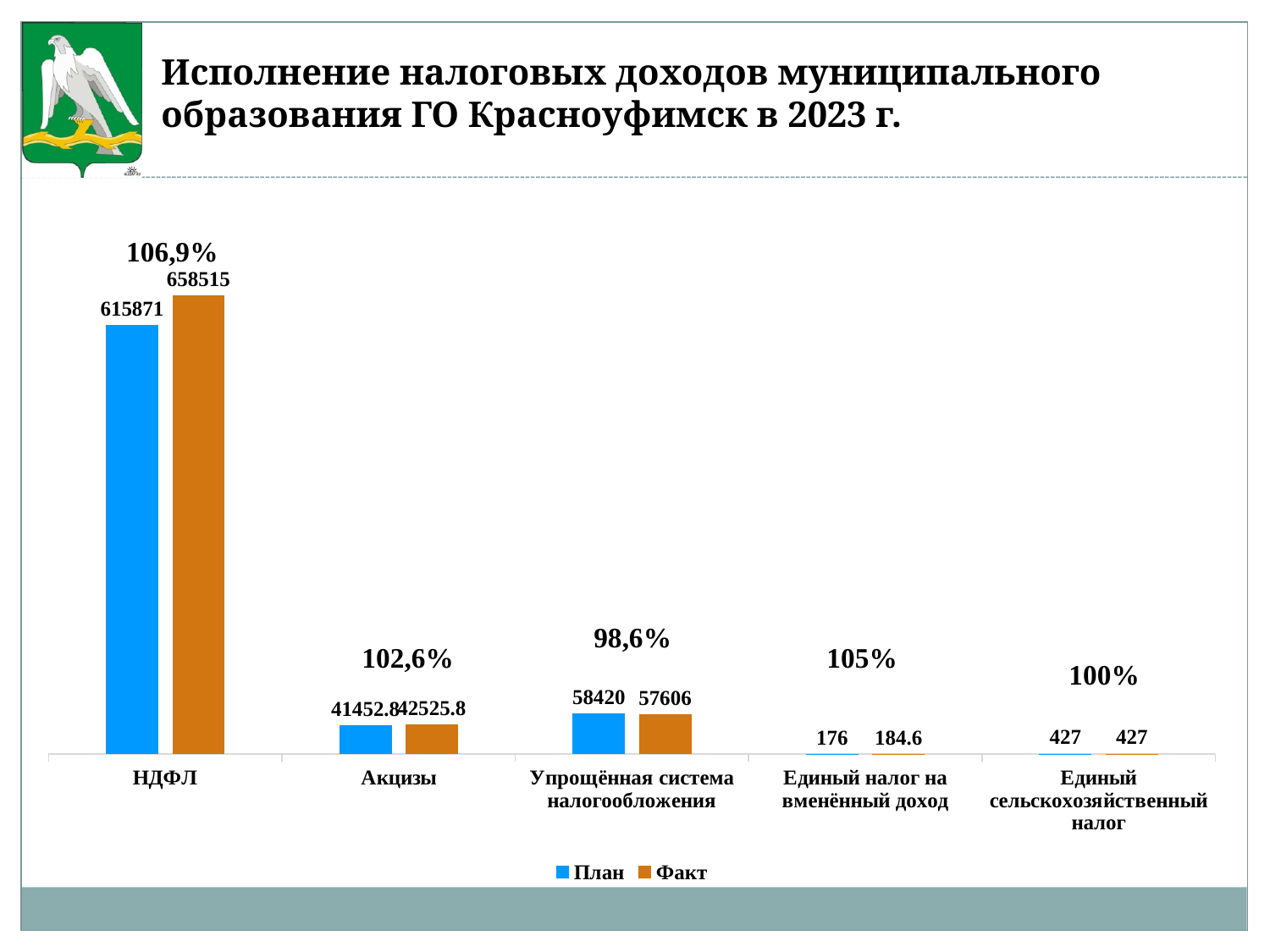
How many series does the legend list? 2 What kind of chart is shown on the slide? bar chart What is the difference between the Факт and План values for НДФЛ? 42644 What is the План value for НДФЛ? 615871 For Упрощённая система налогообложения, which is larger, the План value or the Факт value? План What is the Факт value for Упрощённая система налогообложения? 57606 What is the Факт value for Единый сельскохозяйственный налог? 427 Which category has the highest Факт value? НДФЛ What is the План value for Единый налог на вменённый доход? 176 How many categories are shown on the x axis? 5 Which category has the lowest План value? Единый налог на вменённый доход What is the Факт value for НДФЛ? 658515